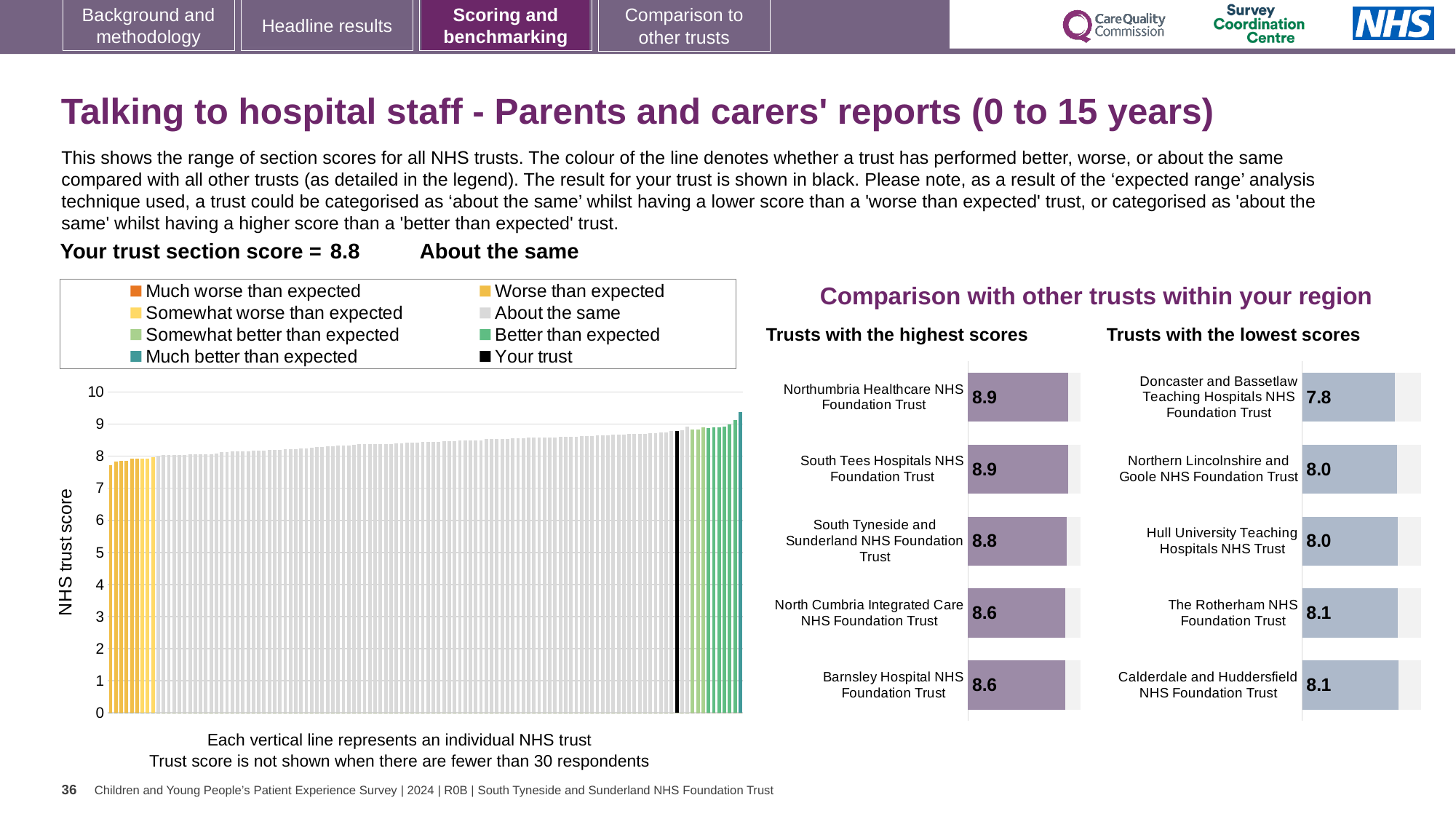
What is the difference between the score for Northumbria Healthcare NHS Foundation Trust in the 'Trusts with the highest scores' chart and the score for Barnsley Hospital NHS Foundation Trust in the same chart? 0.3 In the 'Trusts with the highest scores' chart, what is the score for South Tyneside and Sunderland NHS Foundation Trust? 8.8 How many trusts are shown in the 'Trusts with the highest scores' chart? 5 In the large chart on the left, do the bar heights rise or fall from left to right? rise How many entries does the legend of the large chart on the left list? 8 In the 'Trusts with the lowest scores' chart, what is the score for Hull University Teaching Hospitals NHS Trust? 8.0 In the 'Trusts with the lowest scores' chart, which trust has the lowest score? Doncaster and Bassetlaw Teaching Hospitals NHS Foundation Trust In the large chart on the left, what is the label on the vertical axis? NHS trust score In the large chart on the left, is the value for the black 'Your trust' bar greater or less than 8? greater In the 'Trusts with the highest scores' chart, what is the score for North Cumbria Integrated Care NHS Foundation Trust? 8.6 Which has the larger score: Northumbria Healthcare NHS Foundation Trust in the 'Trusts with the highest scores' chart or Doncaster and Bassetlaw Teaching Hospitals NHS Foundation Trust in the 'Trusts with the lowest scores' chart? Northumbria Healthcare NHS Foundation Trust What type of chart is the large chart on the left showing the range of section scores for all NHS trusts? bar chart